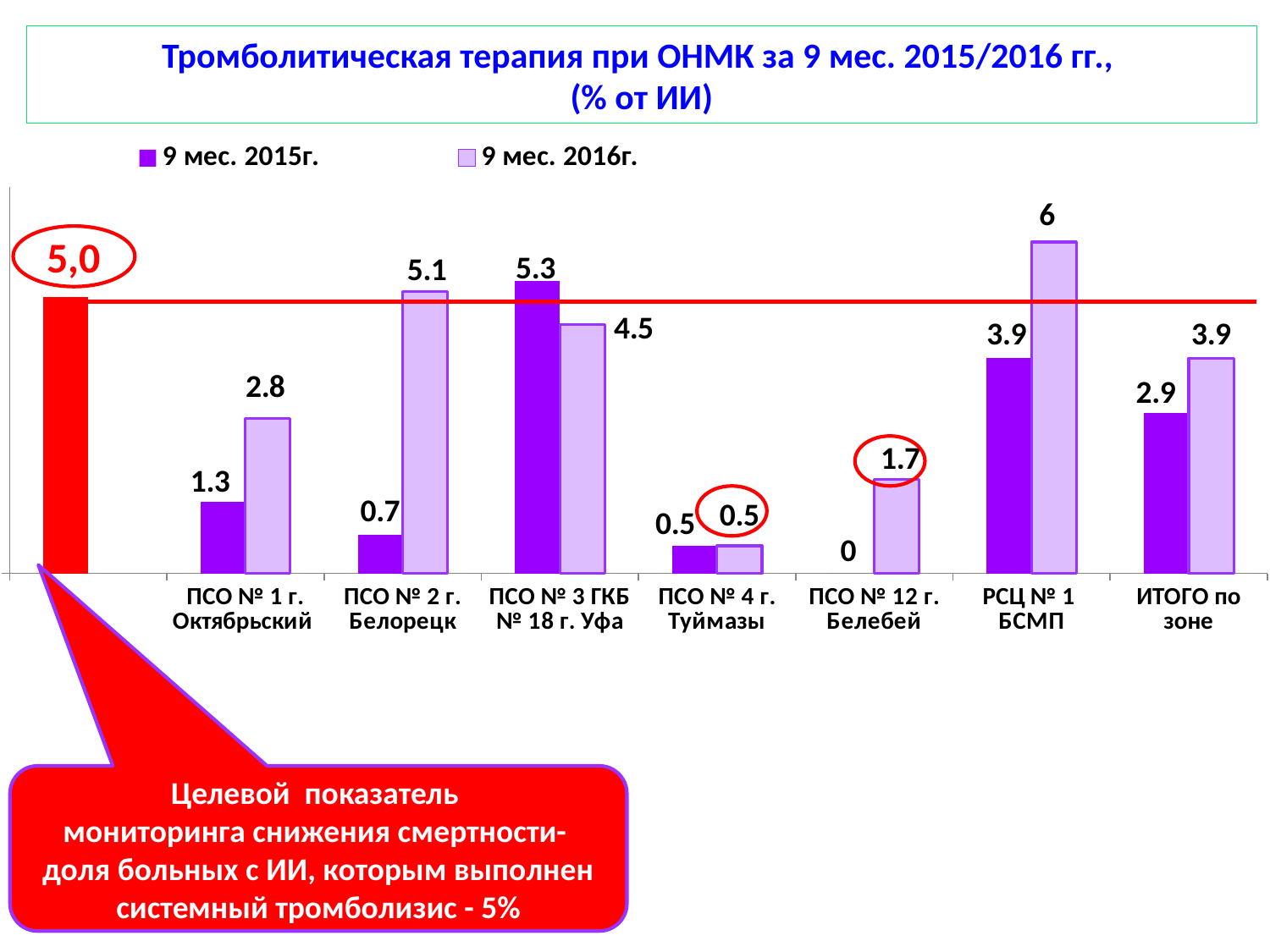
What is the value for ПСО № 12 г. Белебей in the 9 мес. 2015г. series? 0 Which category has the lowest value in the 9 мес. 2015г. series? ПСО № 12 г. Белебей What is the value for РСЦ № 1 БСМП in the 9 мес. 2015г. series? 3.9 What is the value for ИТОГО по зоне in the 9 мес. 2016г. series? 3.9 What is the difference between the 9 мес. 2016г. and 9 мес. 2015г. values for ПСО № 1 г. Октябрьский? 1.5 Which category has the highest value in the 9 мес. 2016г. series? РСЦ № 1 БСМП What kind of chart is shown on the slide? Bar chart What is the value for ПСО № 3 ГКБ № 18 г. Уфа in the 9 мес. 2015г. series? 5.3 How many series does the legend list? 2 For ПСО № 3 ГКБ № 18 г. Уфа, which series has the larger value: 9 мес. 2015г. or 9 мес. 2016г.? 9 мес. 2015г. What value is shown in the red circle next to the red target bar on the left of the chart? 5,0 What is the value for ПСО № 2 г. Белорецк in the 9 мес. 2016г. series? 5.1